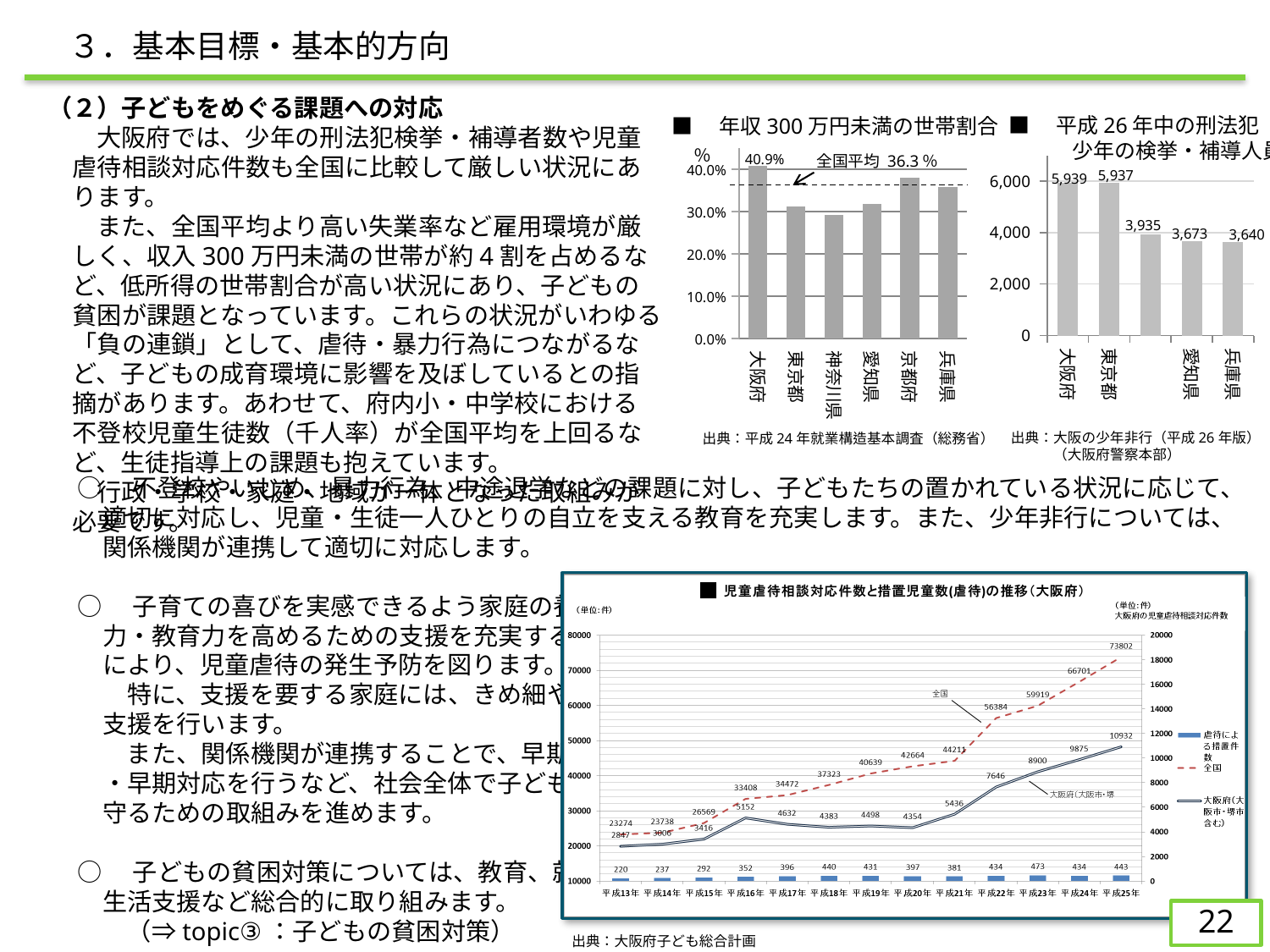
In the chart titled 年収300万円未満の世帯割合, what is the 全国平均 value shown? 36.3% In the chart titled 平成26年中の刑法犯少年の検挙・補導人員, which of 愛知県 and 兵庫県 has the larger value? 愛知県 In the chart titled 年収300万円未満の世帯割合, what is the value for 大阪府? 40.9% In the chart titled 年収300万円未満の世帯割合, which prefecture has the highest value? 大阪府 In the chart titled 児童虐待相談対応件数と措置児童数(虐待)の推移(大阪府), what is the 全国 value for 平成25年? 73802 In the chart titled 平成26年中の刑法犯少年の検挙・補導人員, what is the value for 兵庫県? 3,640 In the chart titled 平成26年中の刑法犯少年の検挙・補導人員, what is the value for 大阪府? 5,939 In the chart titled 平成26年中の刑法犯少年の検挙・補導人員, what is the difference between the values for 東京都 and 愛知県? 2,264 In the chart titled 年収300万円未満の世帯割合, is the value for 神奈川県 greater or less than 30.0%? less In the chart titled 年収300万円未満の世帯割合, how many prefectures are shown on the x axis? 6 In the chart titled 児童虐待相談対応件数と措置児童数(虐待)の推移(大阪府), what is the 虐待による措置件数 bar value for 平成23年? 473 In the chart titled 児童虐待相談対応件数と措置児童数(虐待)の推移(大阪府), how many series does the legend list? 3